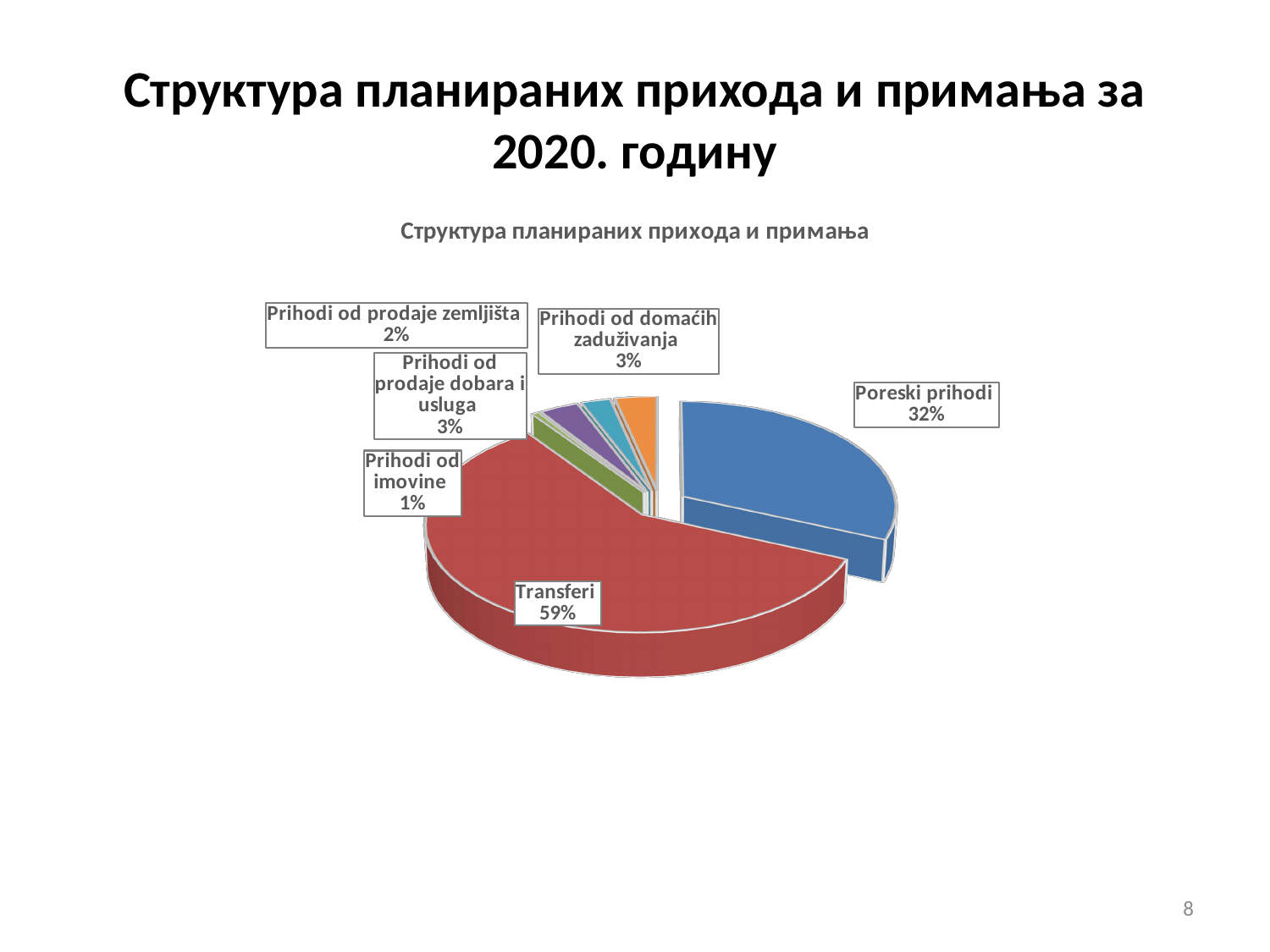
What is the title of the chart? Структура планираних прихода и примања What is the difference in percentage points between Transferi and Poreski prihodi? 27 How many categories are shown in the pie chart? 6 What share of the pie does Prihodi od prodaje zemljišta represent? 2% What share of the pie does Prihodi od domaćih zaduživanja represent? 3% What share of the pie does Transferi represent? 59% Which is larger, the share for Poreski prihodi or the share for Prihodi od prodaje dobara i usluga? Poreski prihodi Which category has the largest slice of the pie? Transferi Which category has the smallest slice of the pie? Prihodi od imovine What type of chart is shown on the slide? Pie chart